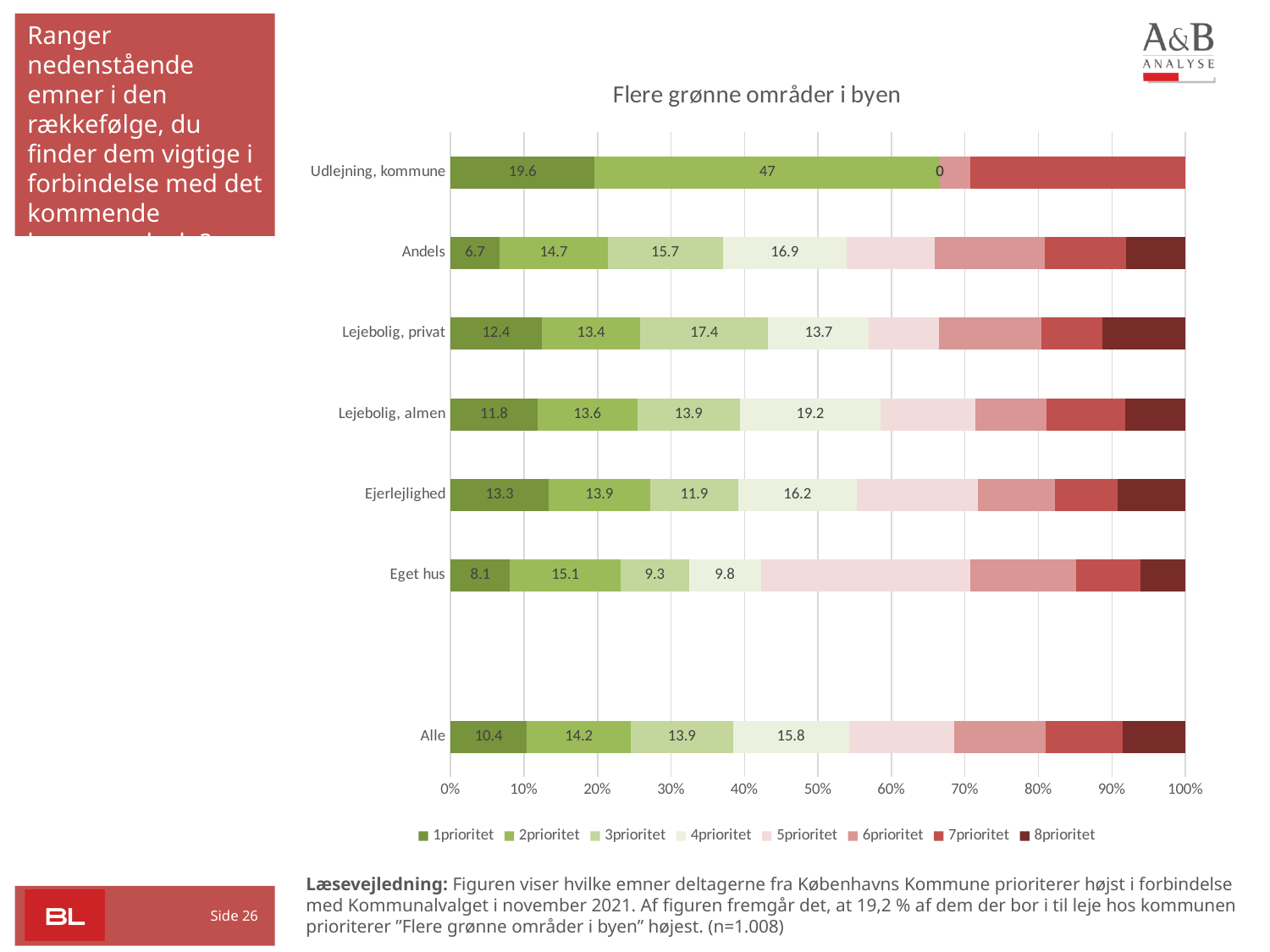
How many categories are shown on the vertical axis? 7 What type of chart is shown on the slide? Stacked bar chart Which is larger: the 3prioritet value for Lejebolig, privat or the 3prioritet value for Andels? Lejebolig, privat What is the 3prioritet value for Eget hus? 9.3 What is the 2prioritet value for Udlejning, kommune? 47 How many series does the legend list? 8 What is the 4prioritet value for Lejebolig, almen? 19.2 What is the title of the chart? Flere grønne områder i byen Which category has the lowest 1prioritet value? Andels What is the difference between the 1prioritet values for Ejerlejlighed and Eget hus? 5.2 Which category has the highest 1prioritet value? Udlejning, kommune What is the 1prioritet value for Udlejning, kommune? 19.6